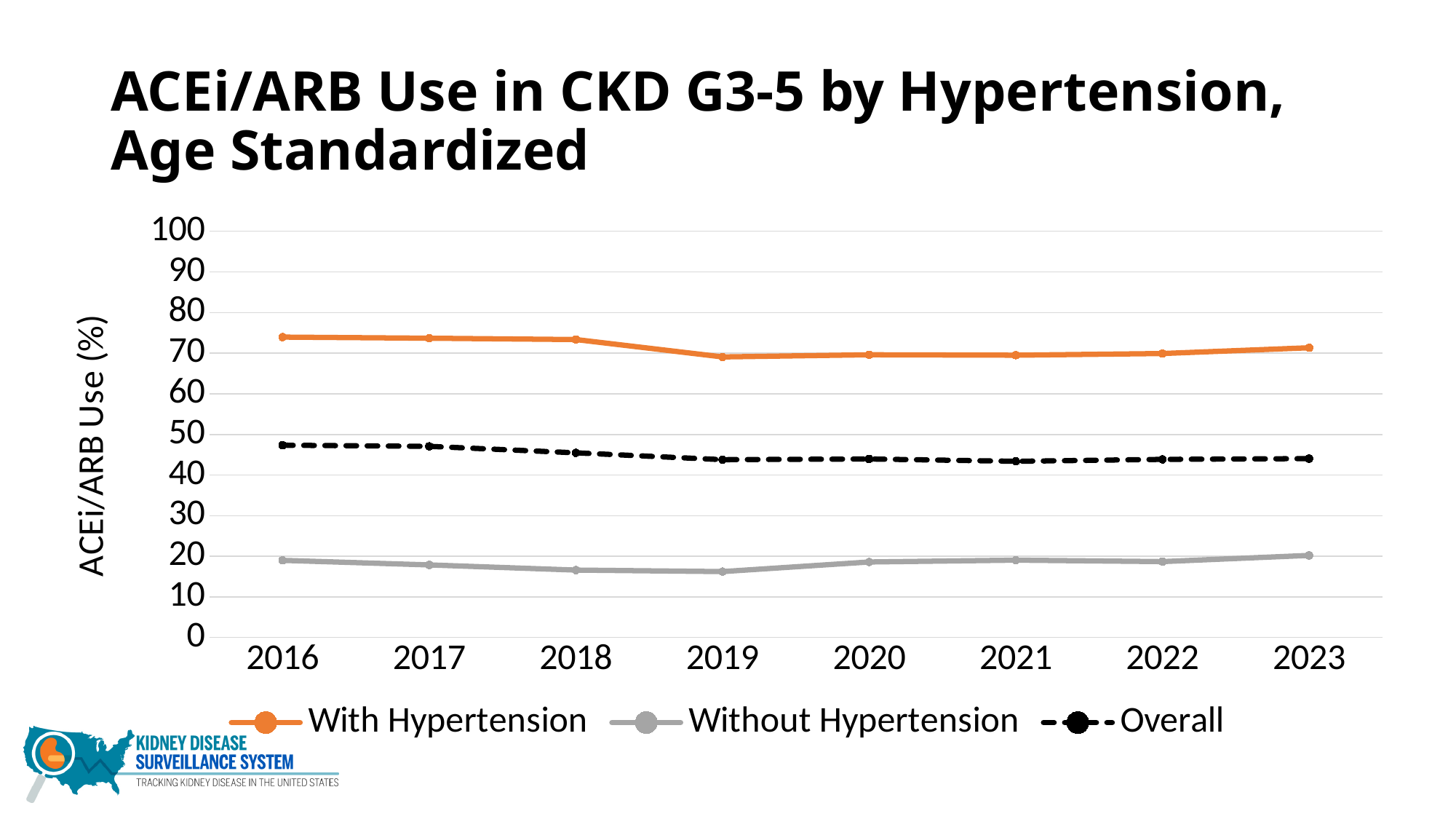
What is the label on the y axis? ACEi/ARB Use (%) Is the value for Overall in 2016 greater or less than 50? less Does the Overall series rise or fall from 2016 to 2023? fall Which series has the lowest ACEi/ARB use across all years? Without Hypertension How many series does the legend list? 3 What kind of chart is shown on the slide? line chart Is the value for With Hypertension in 2016 greater or less than 70? greater Which series has the highest ACEi/ARB use across all years? With Hypertension Is the value for Without Hypertension in 2019 greater or less than 20? less How many years are plotted along the x axis? 8 In 2020, which is larger: the value for With Hypertension or the value for Overall? With Hypertension